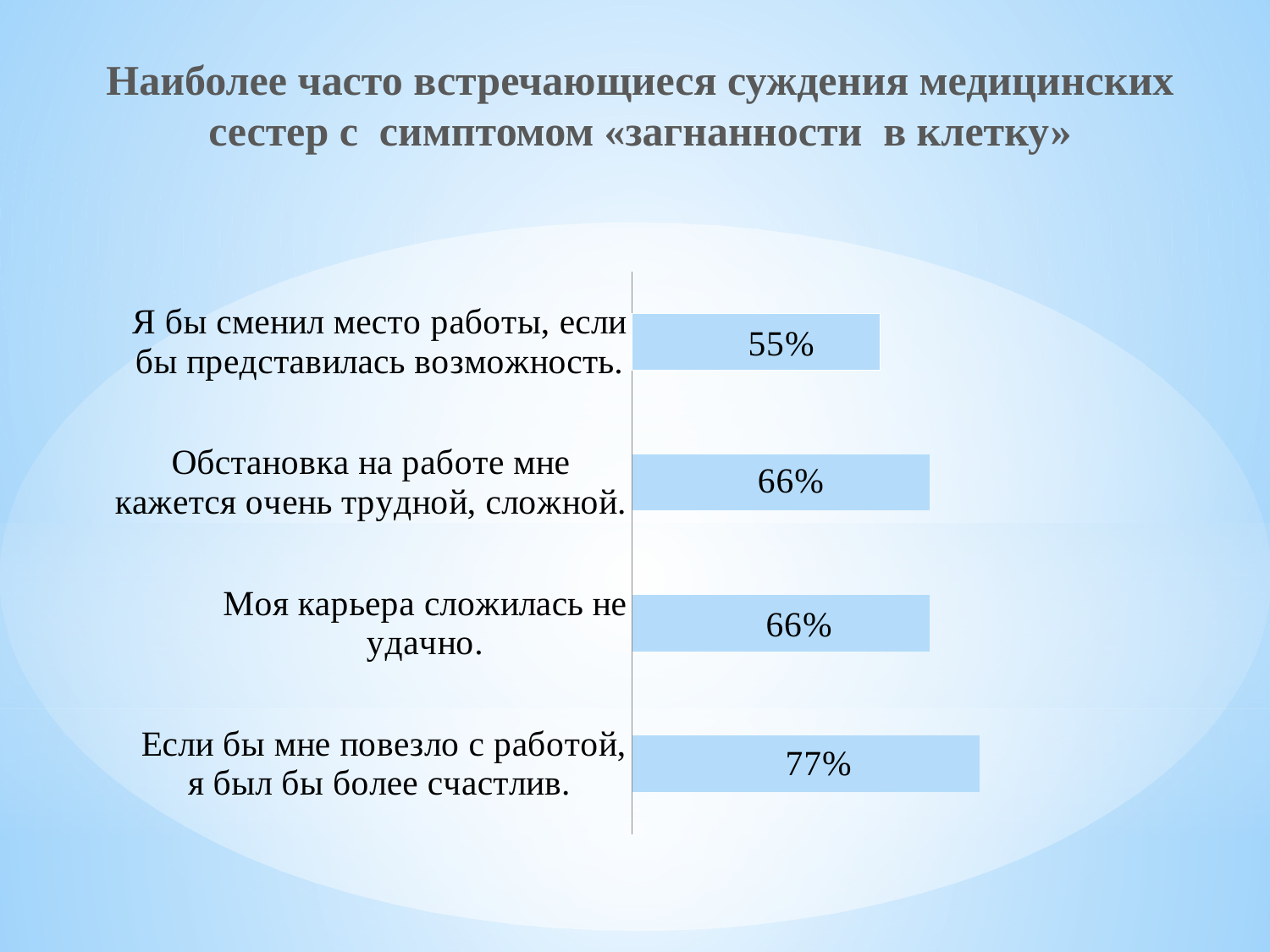
What is the difference between the values for "Если бы мне повезло с работой, я был бы более счастлив." and "Я бы сменил место работы, если бы представилась возможность."? 22% Which statement has the highest value? Если бы мне повезло с работой, я был бы более счастлив. Which is larger: the value for "Обстановка на работе мне кажется очень трудной, сложной." or for "Я бы сменил место работы, если бы представилась возможность."? Обстановка на работе мне кажется очень трудной, сложной. What is the value for "Я бы сменил место работы, если бы представилась возможность."? 55% What is the title of the slide? Наиболее часто встречающиеся суждения медицинских сестер с симптомом «загнанности в клетку» What kind of chart is shown on the slide? Bar chart Which statement has the lowest value? Я бы сменил место работы, если бы представилась возможность. What is the difference between the values for "Моя карьера сложилась не удачно." and "Я бы сменил место работы, если бы представилась возможность."? 11% How many statements (categories) are shown in the chart? 4 What is the value for "Обстановка на работе мне кажется очень трудной, сложной."? 66% What is the value for "Если бы мне повезло с работой, я был бы более счастлив."? 77% What is the value for "Моя карьера сложилась не удачно."? 66%